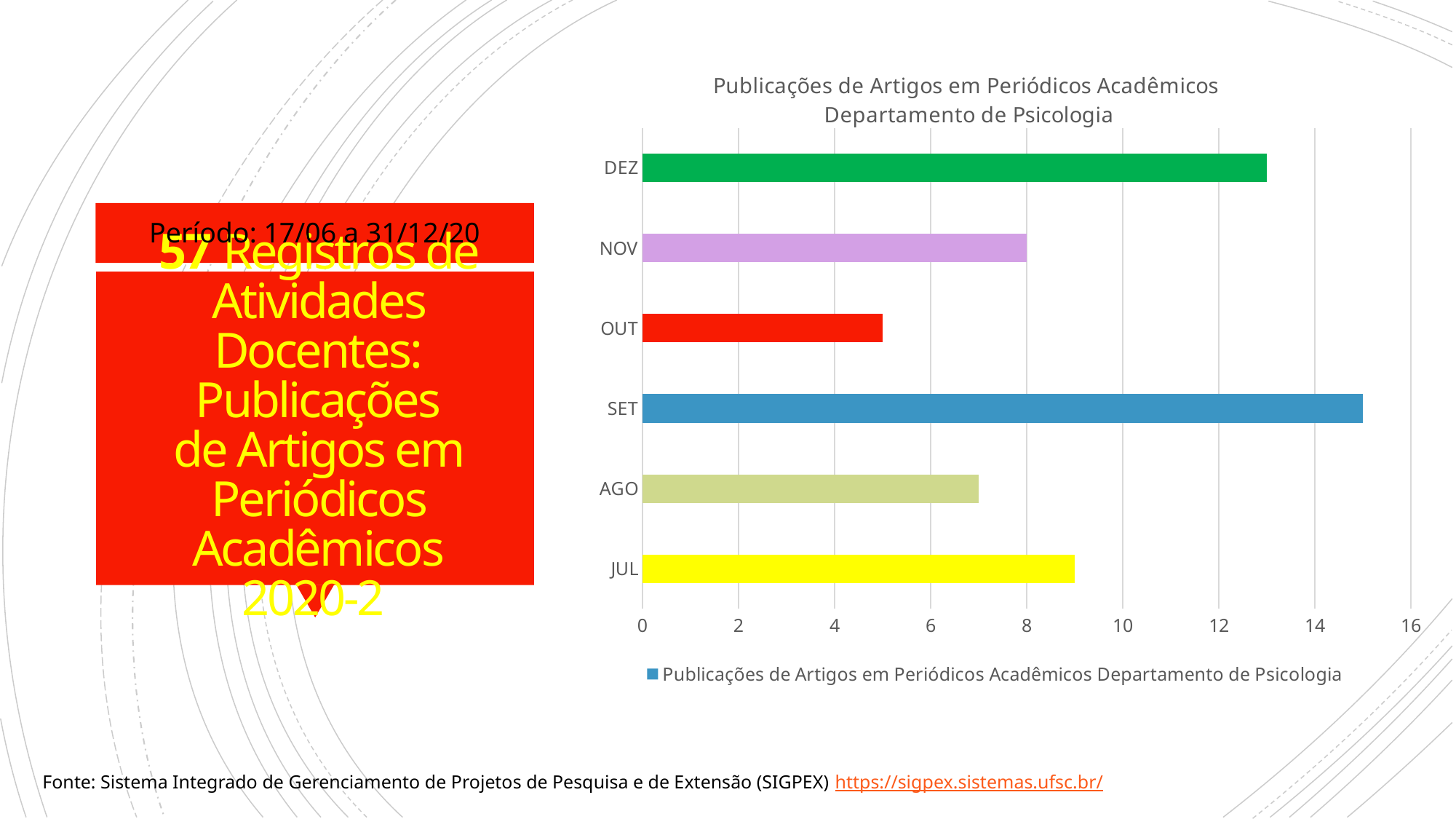
Which is larger, the value for DEZ or the value for NOV? DEZ Is the value for DEZ greater or less than 12? greater Is the value for SET greater or less than 14? greater Is the value for OUT greater or less than 6? less Which month has the highest number of publications? SET What is the title of the chart? Publicações de Artigos em Periódicos Acadêmicos Departamento de Psicologia Which month has the lowest number of publications? OUT What type of chart is shown on the slide? bar chart What is the value for NOV? 8 How many series does the chart legend list? 1 How many months (categories) are shown in the chart? 6